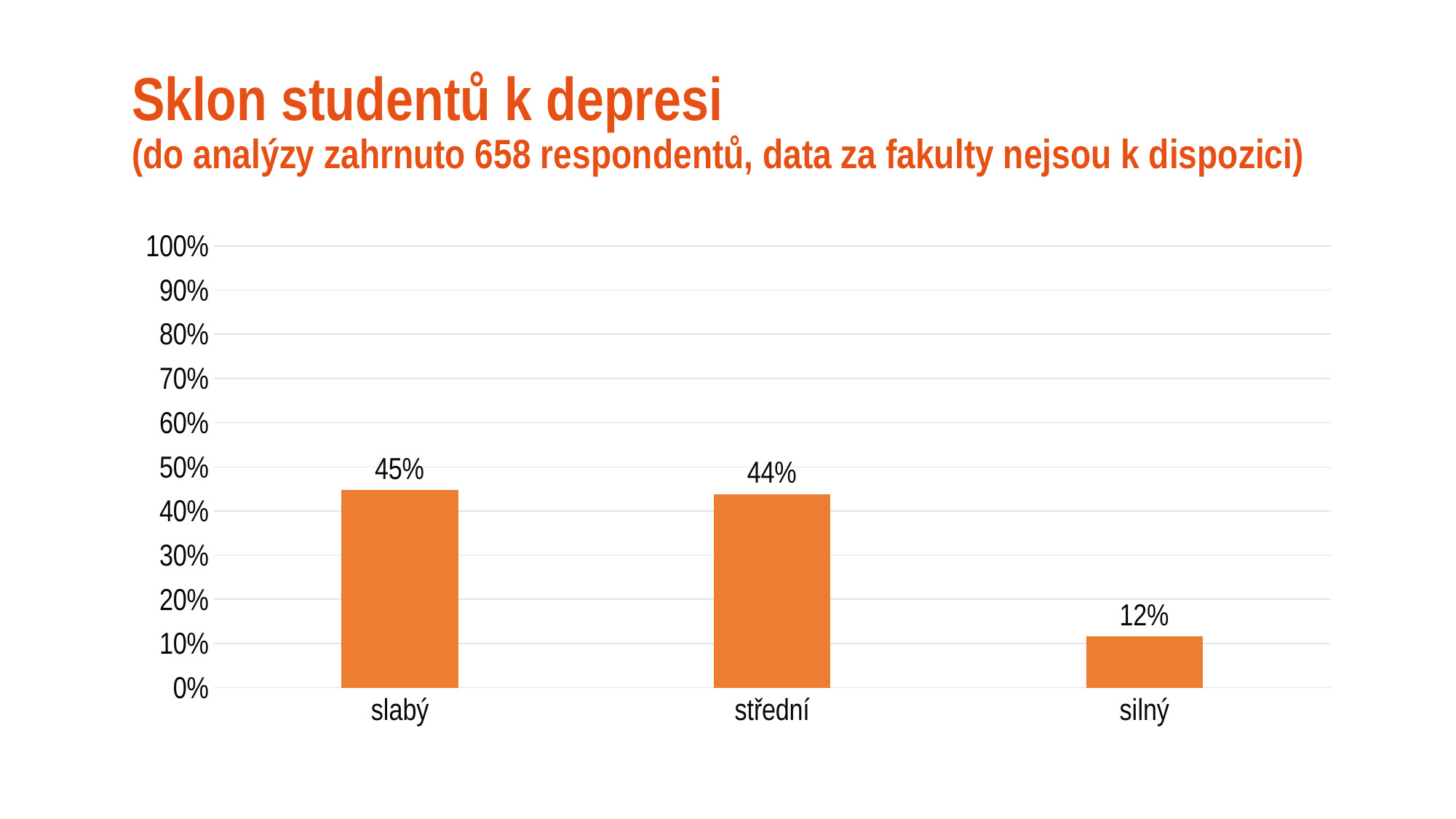
What is the title of the chart on the slide? Sklon studentů k depresi What is the value for silný? 12% What kind of chart is shown on the slide? bar chart What is the difference between the values for střední and silný? 32% What is the difference between the values for slabý and silný? 33% How many categories are shown on the x axis? 3 Which is larger, the value for střední or the value for silný? střední Which category has the lowest value? silný Is the value for slabý greater or less than 40%? greater What is the value for slabý? 45% What is the value for střední? 44% Is the value for silný greater or less than 20%? less